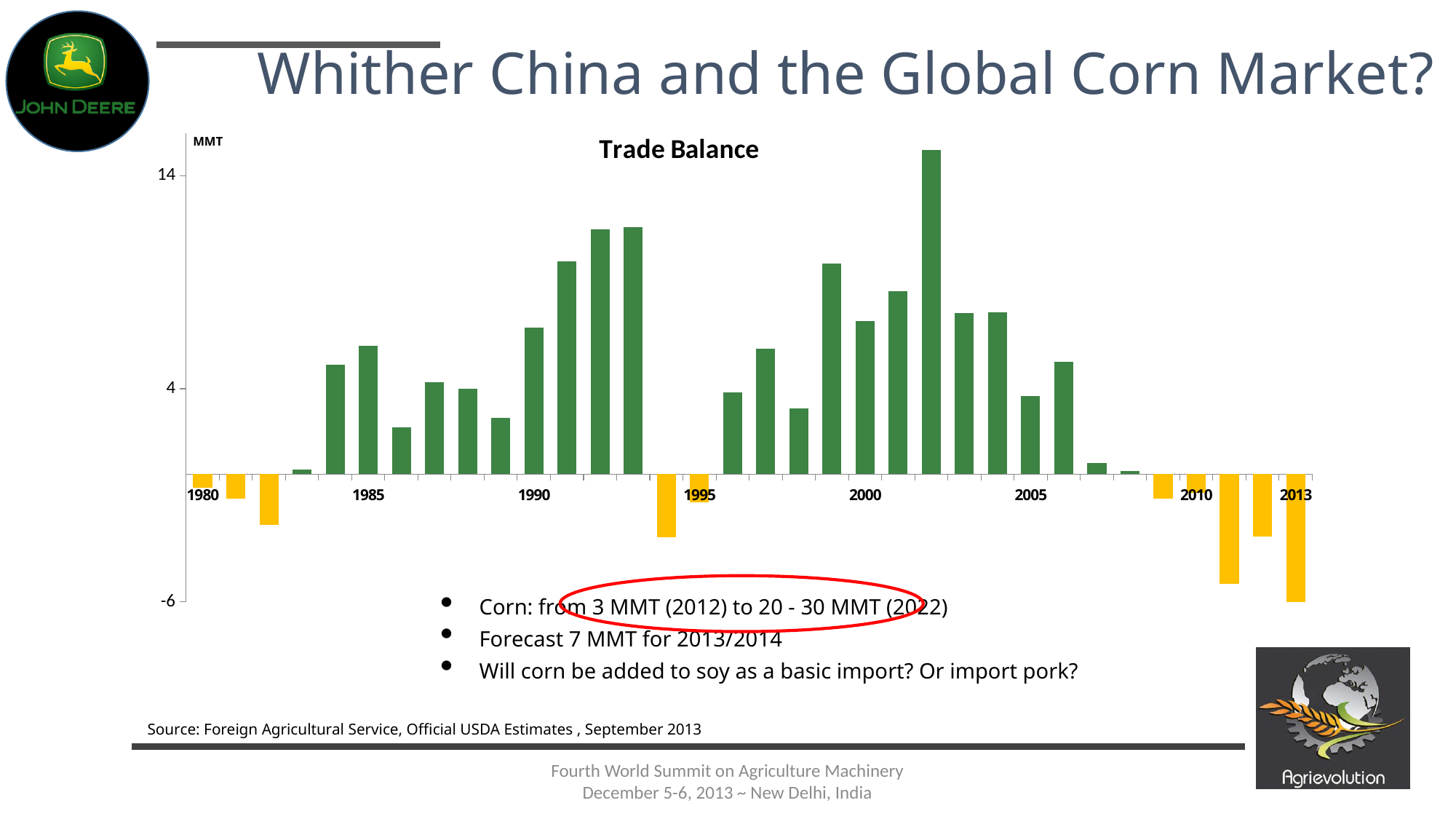
Which year has the larger trade balance, 1992 or 1985? 1992 Is the trade balance for 1992 greater or less than 4? greater How many years (bars) are plotted in the chart? 34 What is the title of the chart? Trade Balance Which year has the larger trade balance, 2002 or 1999? 2002 What kind of chart is shown on the slide? bar chart What unit is shown on the chart's vertical axis? MMT Is the trade balance for 1986 greater or less than 4? less Which year has the lowest trade balance in the chart? 2013 Which year has the highest trade balance in the chart? 2002 Is the trade balance for 1985 greater or less than 4? greater Do the trade balance values rise or fall from 2008 to 2013? fall